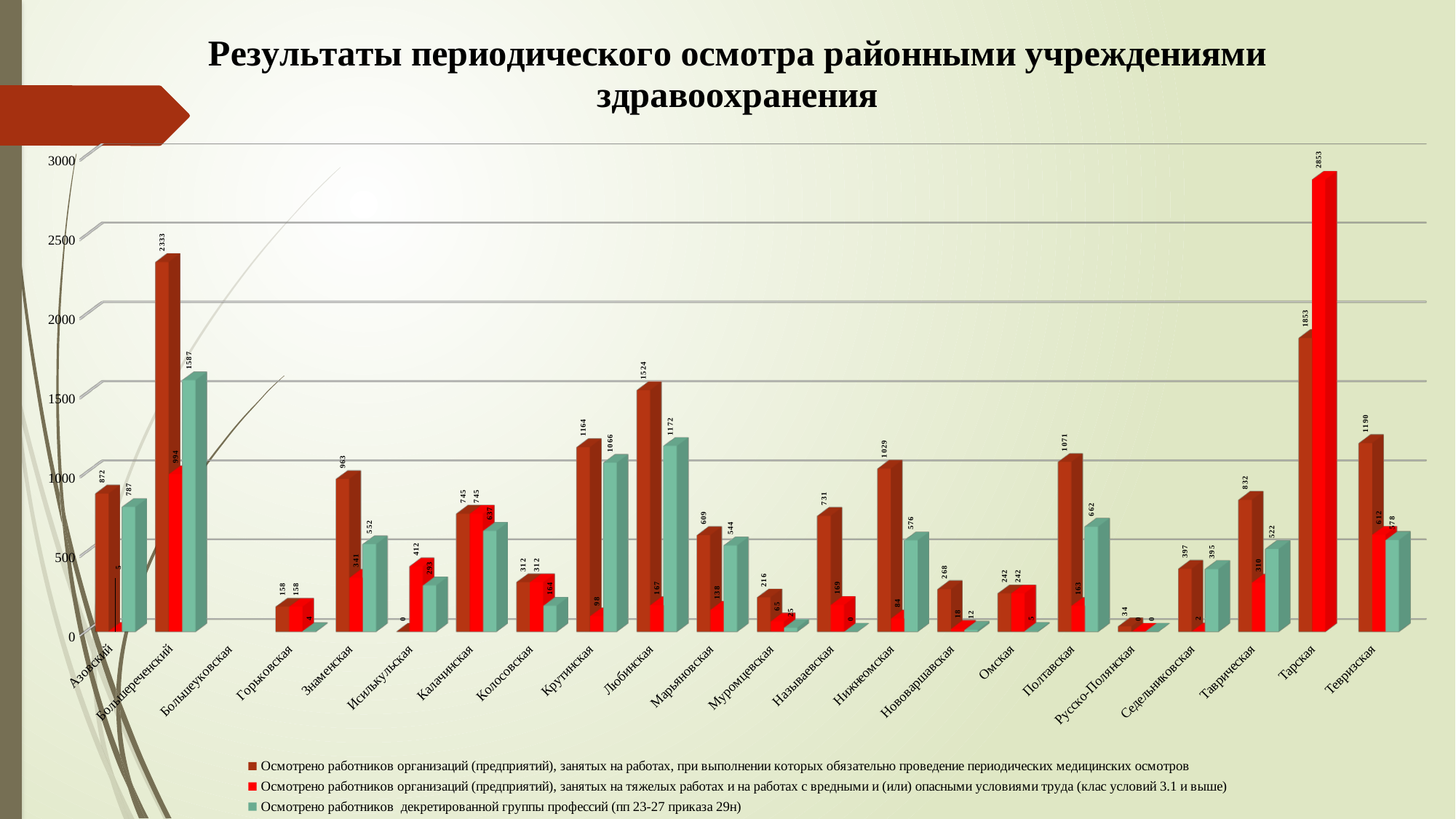
What is the value of the teal series (декретированная группа профессий) for Любинская? 1172 What type of chart is shown on the slide? bar chart Which category has the highest value in the red series (тяжелые и вредные условия труда)? Тарская What is the value of the red series (тяжелые и вредные условия труда) for Тарская? 2853 Is the dark red series value for Тарская greater or less than 1500? greater How many series does the legend list? 3 What is the difference between the dark red series values for Любинская (1524) and Крутинская (1164)? 360 Which is larger: the teal series value for Полтавская or for Нижнеомская? Полтавская What is the value of the teal series for Таврическая? 522 Which category has the highest value in the dark red series (обязательные периодические медосмотры)? Большереченский What is the value of the dark red series for Азовский? 872 What is the value of the dark red series (обязательные периодические медосмотры) for Большереченский? 2333